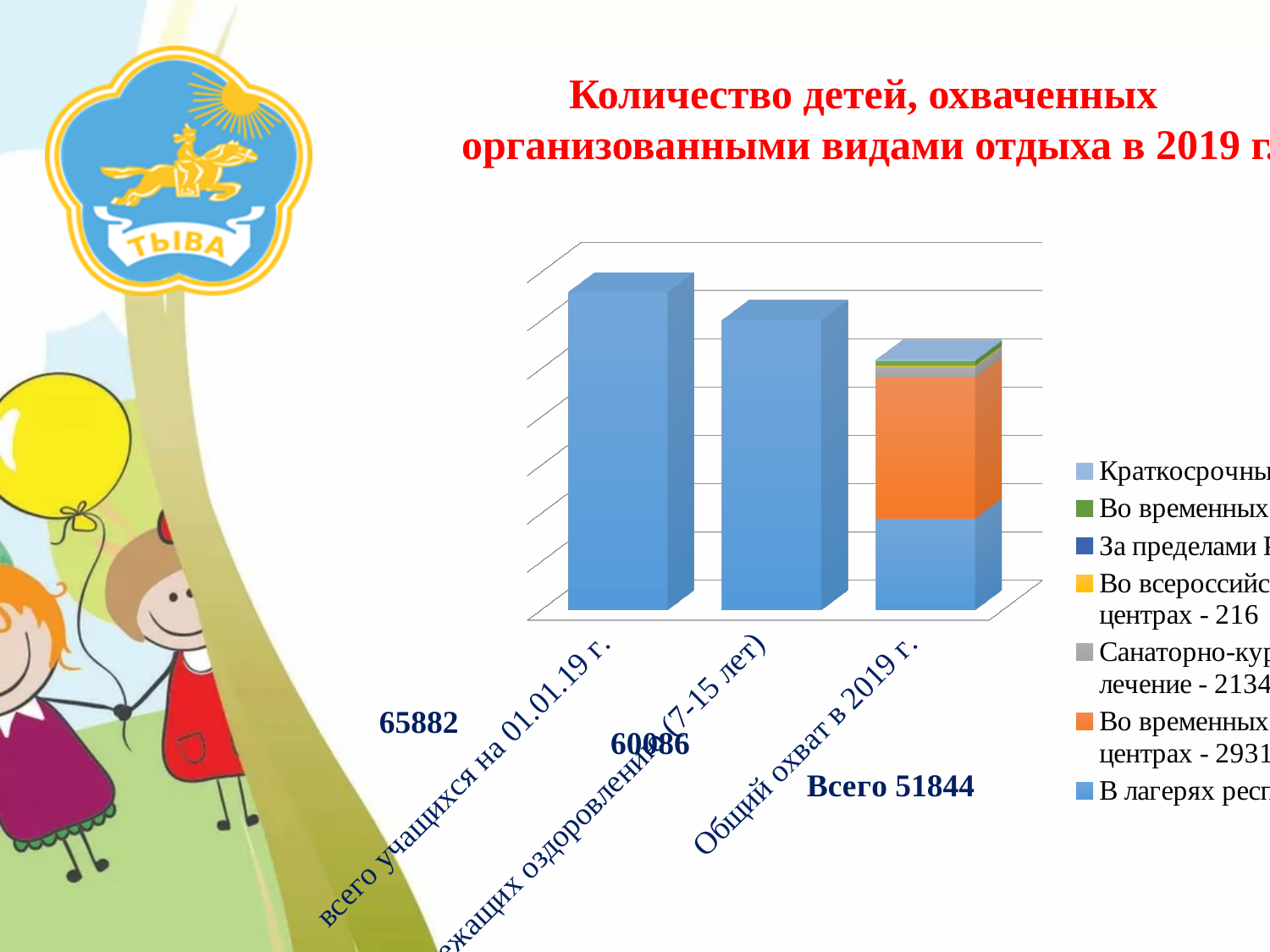
What total is shown for "Общий охват в 2019 г."? 51844 Which category has the highest bar? всего учащихся на 01.01.19 г. How many bars (categories) does the chart show? 3 Which category has the lowest bar? Общий охват в 2019 г. What is the value shown for "всего учащихся на 01.01.19 г."? 65882 How many entries does the legend list? 7 Which category is shown as a stacked bar made of several coloured segments? Общий охват в 2019 г. What colour is the largest segment of the stacked bar for "Общий охват в 2019 г."? orange What is the difference between the value for "всего учащихся на 01.01.19 г." (65882) and the total for "Общий охват в 2019 г." (51844)? 14038 Which is larger: the value for "всего учащихся на 01.01.19 г." or the total for "Общий охват в 2019 г."? всего учащихся на 01.01.19 г. What kind of chart is shown on the slide? bar chart Do the bar heights rise or fall from left to right across the chart? fall